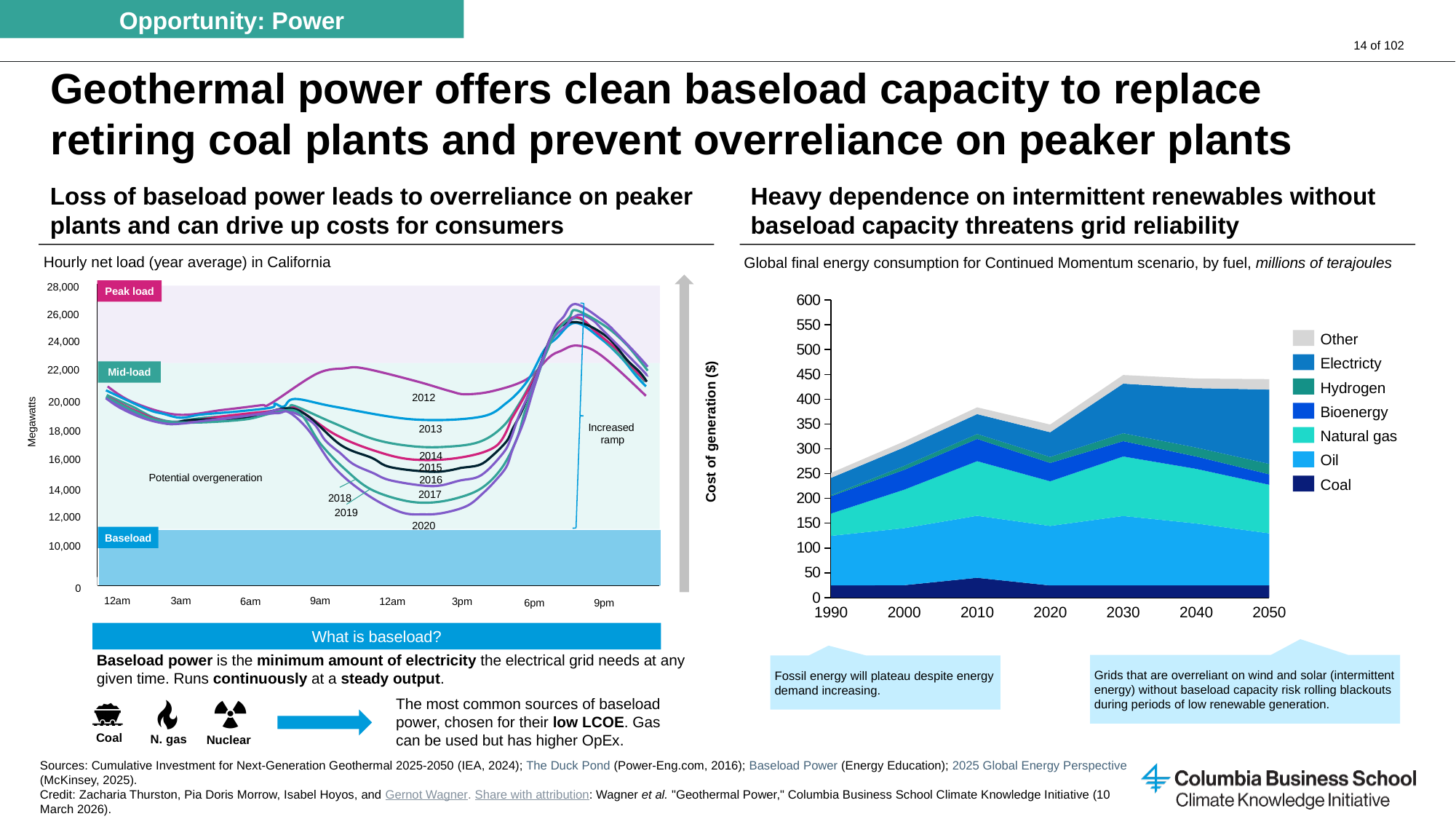
On the left chart, 'Hourly net load (year average) in California', which load band is shaded at the bottom of the chart? Baseload On the right chart, 'Global final energy consumption for Continued Momentum scenario, by fuel', is the total consumption in 2030 greater or less than 400? greater On the right chart, 'Global final energy consumption for Continued Momentum scenario, by fuel', how many year labels are shown on the x-axis? 7 On the left chart, 'Hourly net load (year average) in California', what unit is shown on the y-axis? Megawatts On the right chart, 'Global final energy consumption for Continued Momentum scenario, by fuel', which is larger: total consumption in 1990 or in 2030? 2030 On the left chart, 'Hourly net load (year average) in California', is the evening peak of the 2020 line greater or less than 24,000? greater On the left chart, 'Hourly net load (year average) in California', does the 2020 line rise or fall between 6am and 12pm? fall On the right chart, 'Global final energy consumption for Continued Momentum scenario, by fuel', is the total consumption in 1990 greater or less than 300? less What kind of chart is the right chart, 'Global final energy consumption for Continued Momentum scenario, by fuel'? stacked area chart On the left chart, 'Hourly net load (year average) in California', how many years are plotted as separate lines? 9 What kind of chart is the left chart, 'Hourly net load (year average) in California'? line chart On the right chart, 'Global final energy consumption for Continued Momentum scenario, by fuel', how many fuel series does the legend list? 7